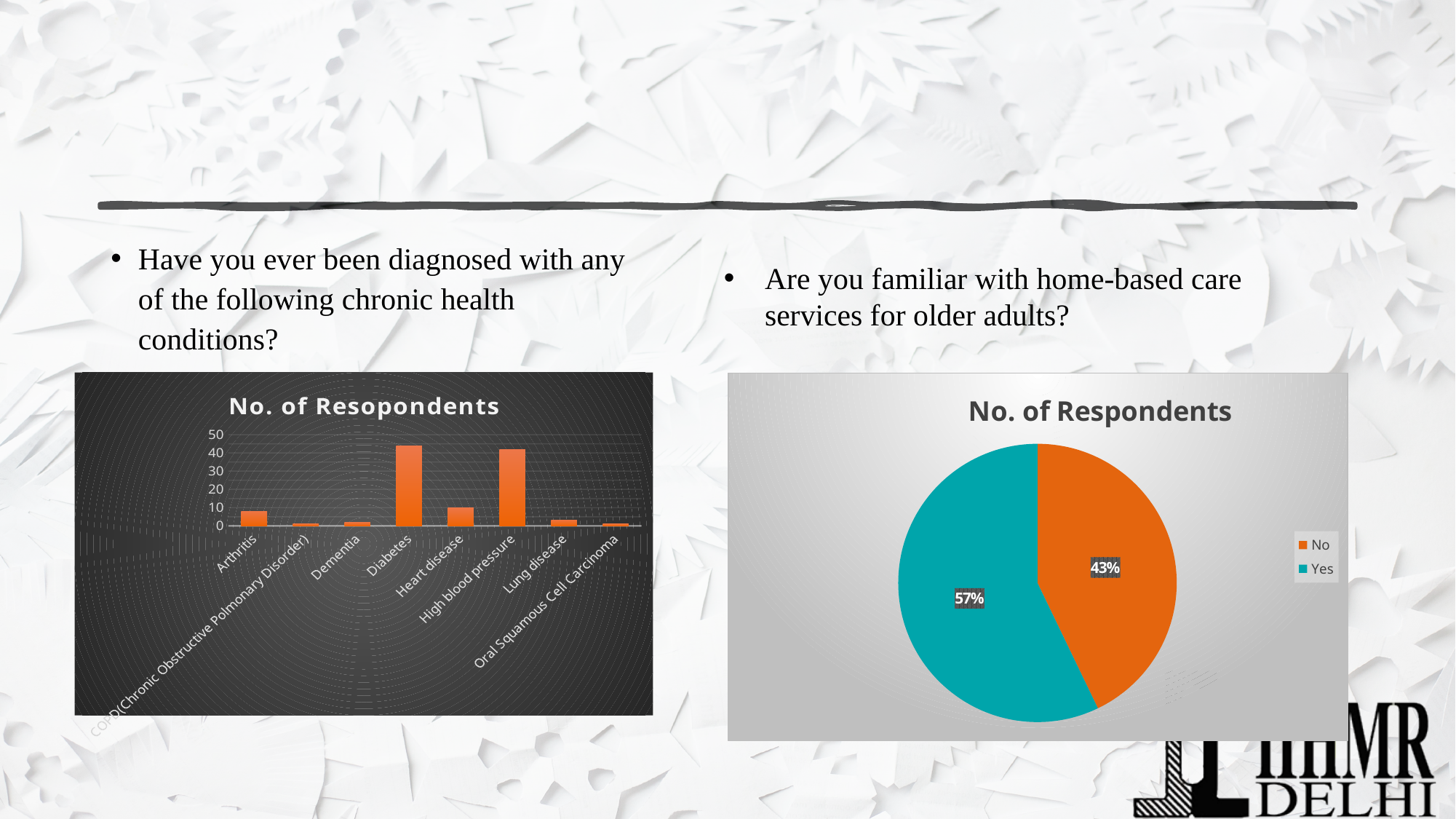
In the left bar chart, is the value for Arthritis greater or less than 10? less In the right pie chart, what share of respondents answered 'Yes'? 57% What kind of chart is the right chart titled 'No. of Respondents'? pie chart In the left bar chart, which is larger, the value for Diabetes or the value for Heart disease? Diabetes In the left bar chart, which is larger, the value for Lung disease or the value for High blood pressure? High blood pressure What kind of chart is the left chart titled 'No. of Resopondents'? bar chart In the right pie chart, which slice is larger, 'Yes' or 'No'? Yes In the left bar chart, is the value for High blood pressure greater or less than 30? greater In the right pie chart, what share of respondents answered 'No'? 43% How many categories are shown on the x axis of the left bar chart? 8 How many entries does the legend of the right pie chart list? 2 In the left bar chart, is the value for Diabetes greater or less than 40? greater